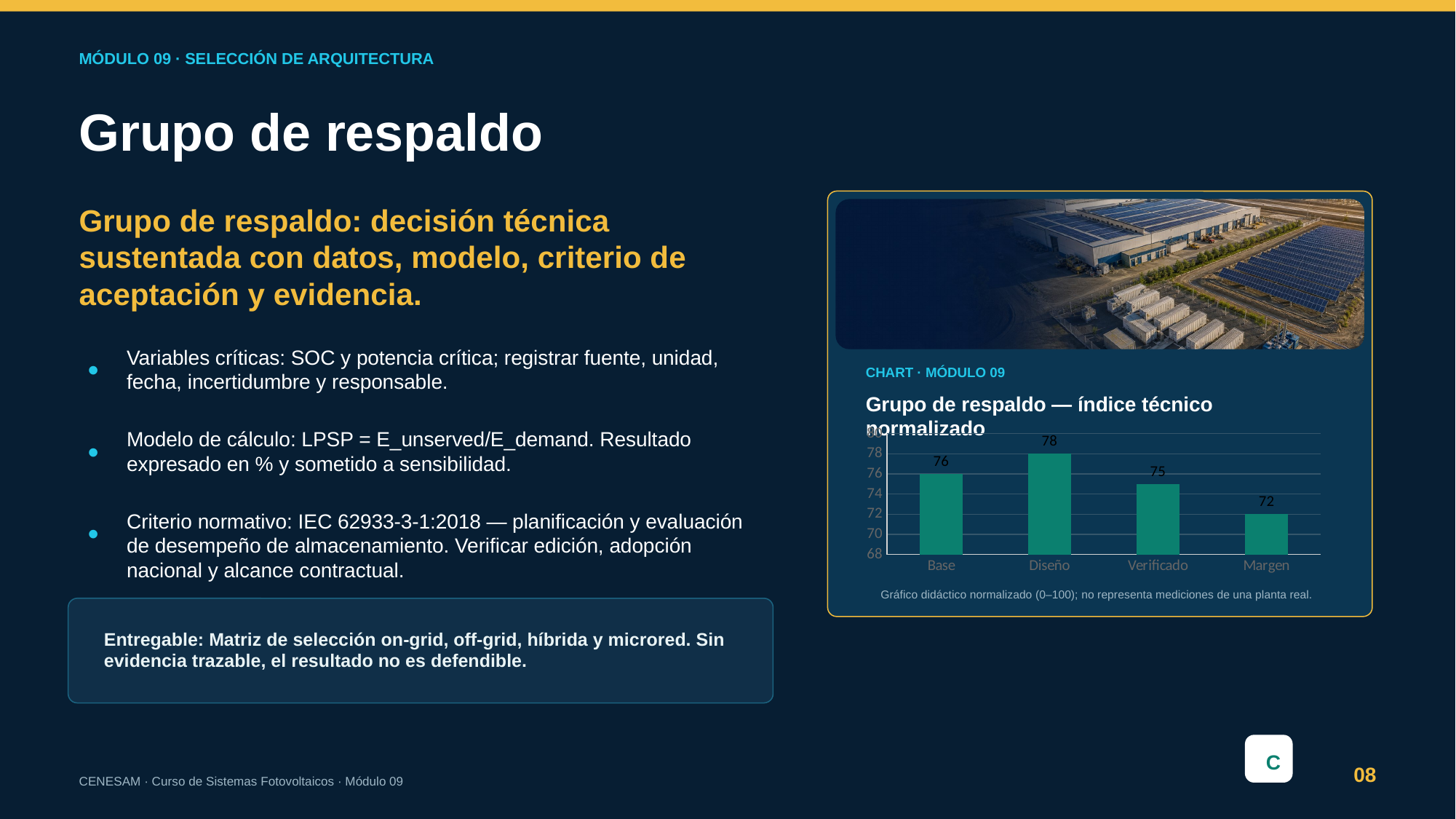
What is the title of the chart? Grupo de respaldo — índice técnico normalizado What is the value for Base? 76 What is the difference between the values for Diseño and Margen? 6 How many categories are shown on the x axis? 4 What is the value for Diseño? 78 Which category has the lowest value? Margen What kind of chart is shown? bar chart What is the value for Margen? 72 What is the value for Verificado? 75 Which category has the highest value? Diseño Is the value for Margen greater or less than 74? less Which is larger, the value for Base or the value for Verificado? Base